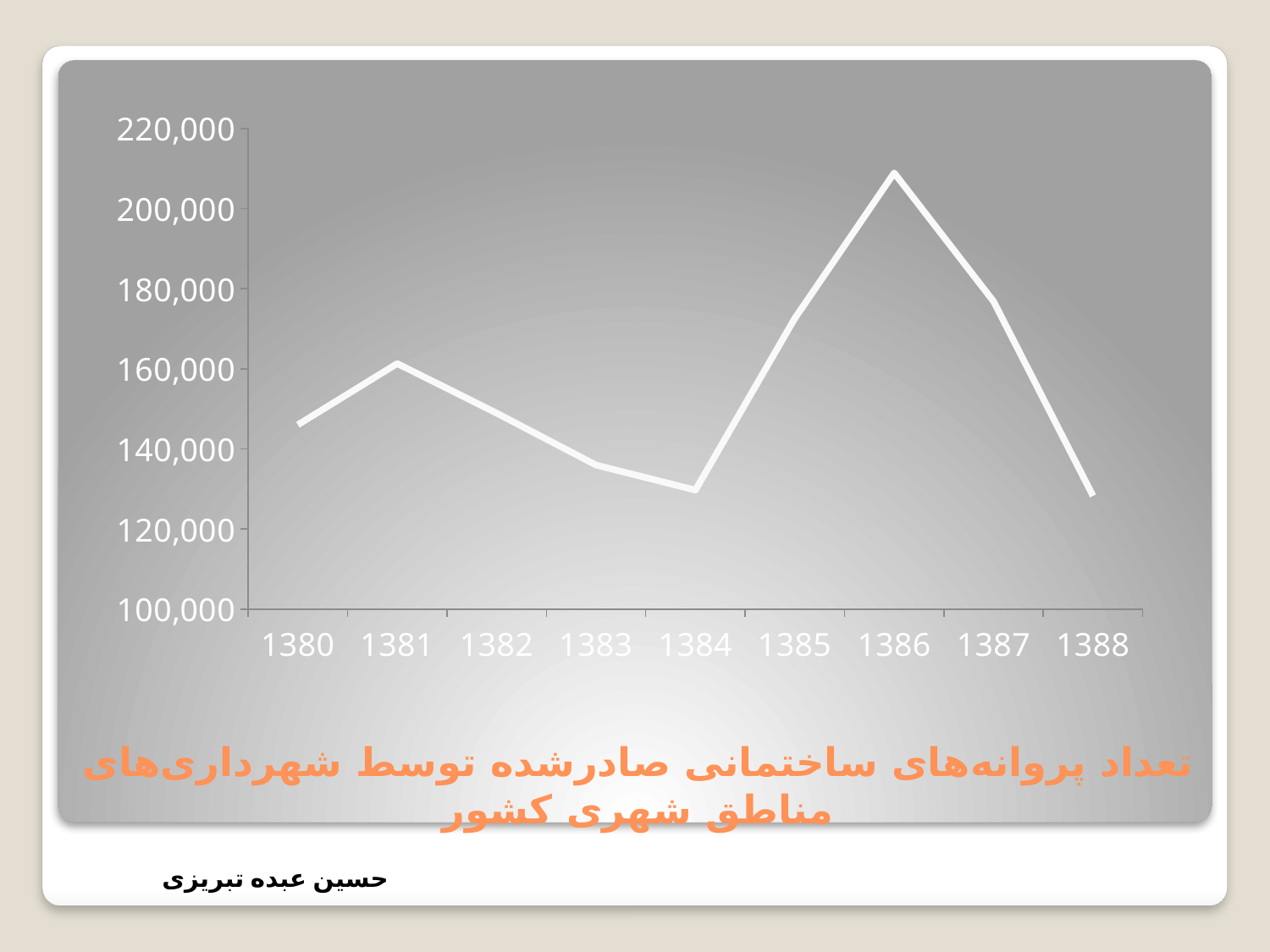
Which is larger, the value for 1380 or the value for 1384? 1380 What kind of chart is shown on the slide? line chart Is the value for 1386 greater or less than 200,000? greater Which year has the highest value on the chart? 1386 Which is larger, the value for 1381 or the value for 1386? 1386 Is the value for 1385 greater or less than 160,000? greater Is the value for 1384 greater or less than 140,000? less Do the values rise or fall from 1386 to 1388? fall How many years are plotted along the x axis? 9 Do the values rise or fall from 1384 to 1386? rise